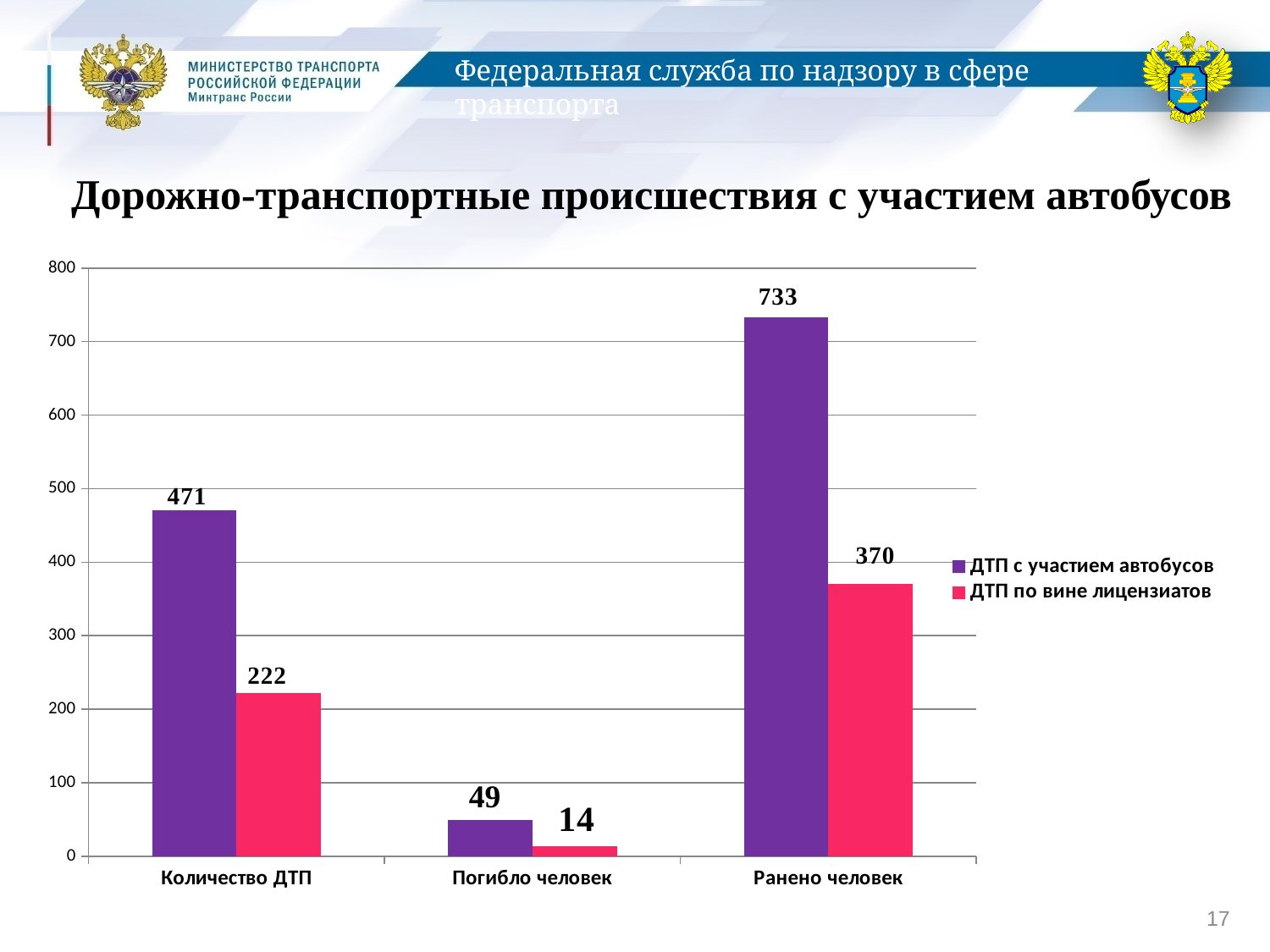
What colour are the bars for the "ДТП по вине лицензиатов" series? Pink What kind of chart is shown on the slide? Bar chart What is the difference between the two series for "Количество ДТП"? 249 What is the value for "Погибло человек" in the "ДТП по вине лицензиатов" series? 14 How many series does the legend list? 2 Which is larger: "ДТП с участием автобусов" for "Погибло человек" or "ДТП по вине лицензиатов" for "Количество ДТП"? ДТП по вине лицензиатов for Количество ДТП Which category has the highest value in the "ДТП с участием автобусов" series? Ранено человек What is the difference between the two series for "Ранено человек"? 363 What is the value for "Ранено человек" in the "ДТП по вине лицензиатов" series? 370 How many categories are shown on the x axis? 3 What is the value for "Количество ДТП" in the "ДТП с участием автобусов" series? 471 Which category has the lowest value in the "ДТП по вине лицензиатов" series? Погибло человек